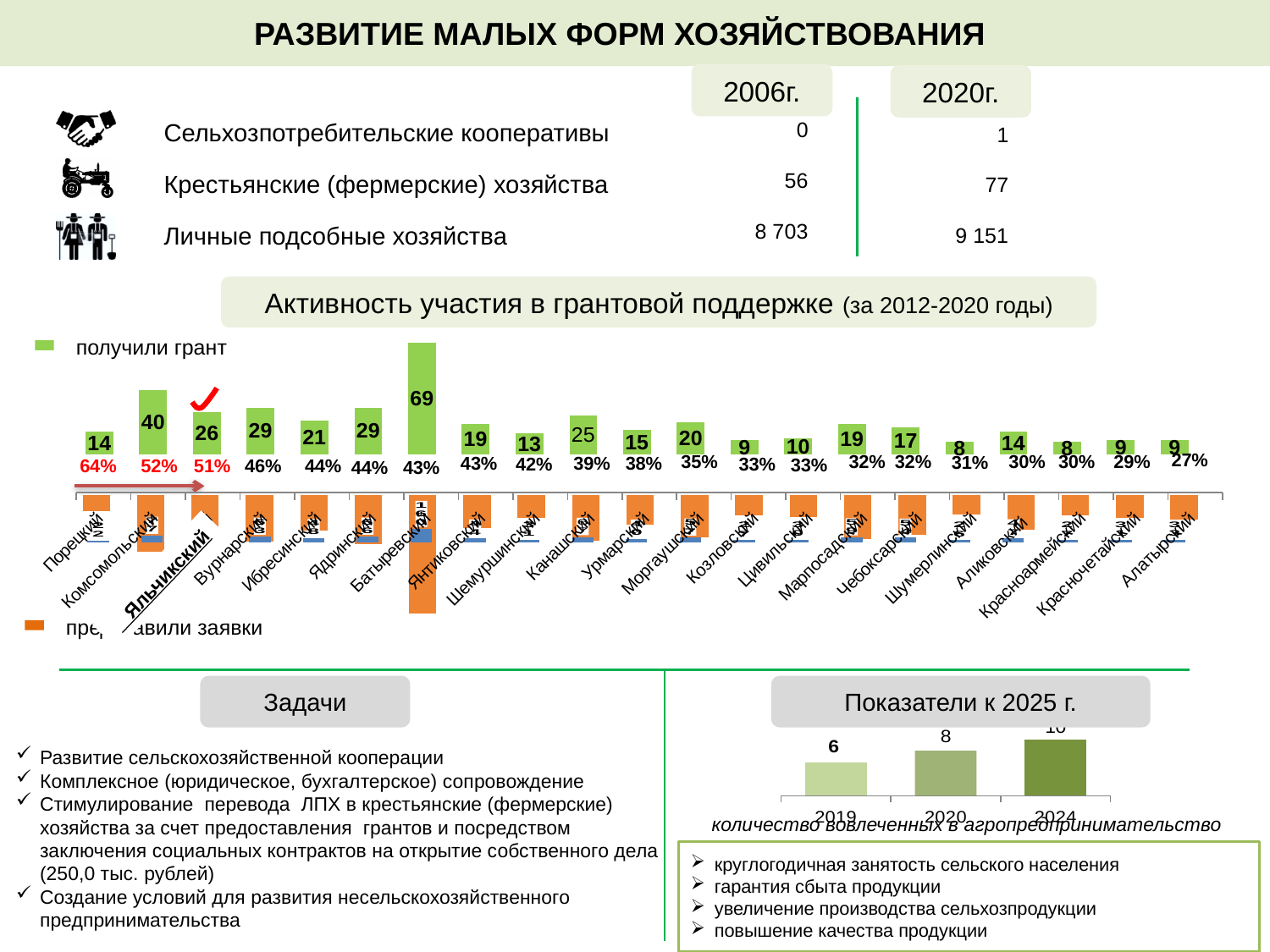
In the chart 'Активность участия в грантовой поддержке', how many grants did Батыревский receive (green bar)? 69 In the chart 'Показатели к 2025 г.', do the values rise or fall from 2019 to 2024? Rise In the chart 'Активность участия в грантовой поддержке', which district has the lowest percentage shown? Алатырский In the chart 'Активность участия в грантовой поддержке', which received more grants: Яльчикский or Вурнарский? Вурнарский In the chart 'Активность участия в грантовой поддержке', how many districts are shown on the x axis? 21 In the chart 'Активность участия в грантовой поддержке', how many grants did Комсомольский receive? 40 In the chart 'Показатели к 2025 г.', what is the value for 2019? 6 In the chart 'Активность участия в грантовой поддержке', what percentage is shown for Порецкий? 64% In the chart 'Активность участия в грантовой поддержке', what is the difference between the grants received by Батыревский and Комсомольский? 29 In the chart 'Активность участия в грантовой поддержке', what colour are the bars for 'получили грант'? Green In the chart 'Активность участия в грантовой поддержке', which district has the highest number of grants received (green bar)? Батыревский In the chart 'Активность участия в грантовой поддержке', how many series does the legend list? 2